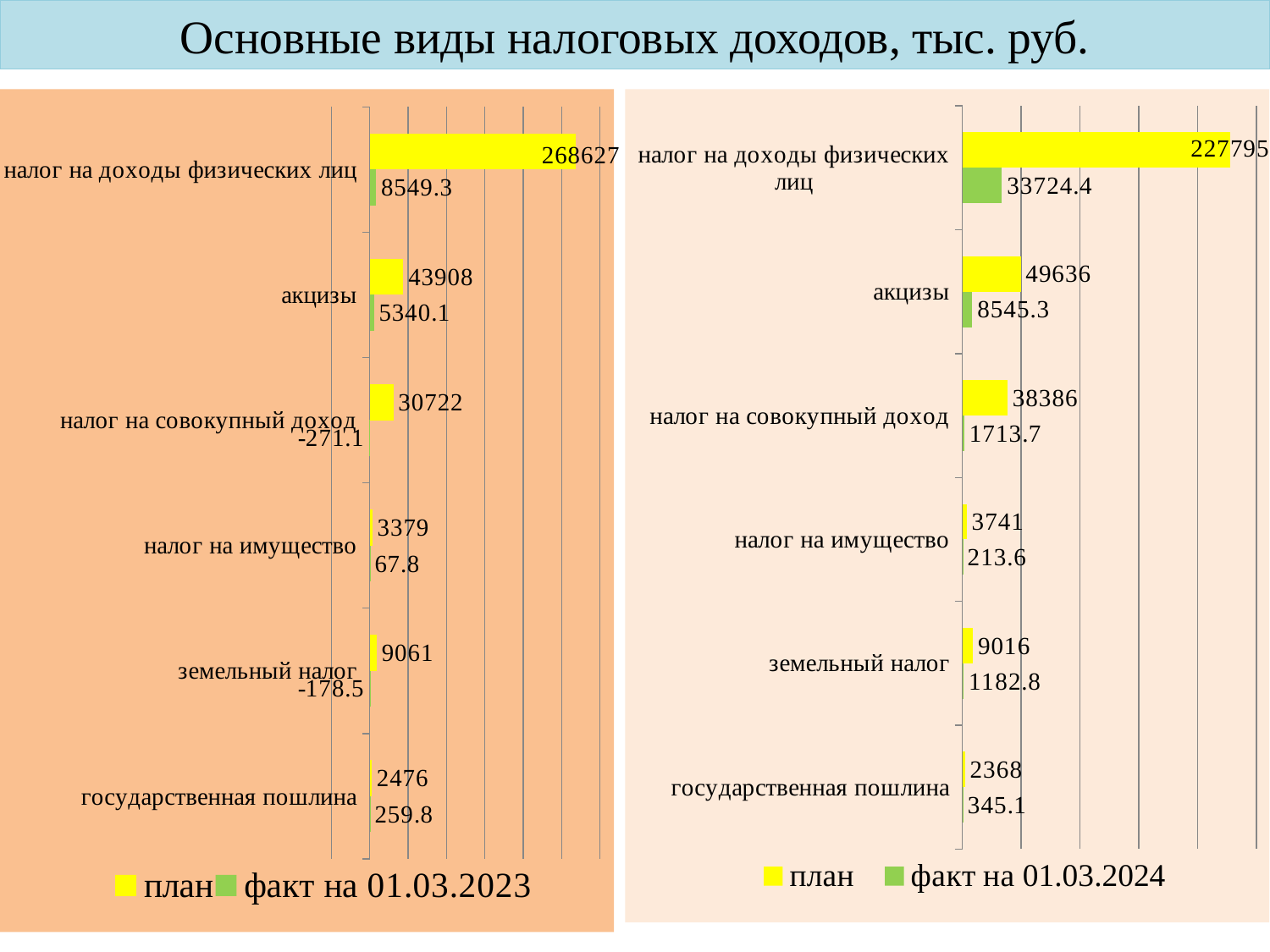
Which is larger: the план value for акцизы in the left chart or in the right chart? right chart (49636) In the left chart (факт на 01.03.2023), which category has the lowest факт value? налог на совокупный доход In the left chart (факт на 01.03.2023), what is the факт value for земельный налог? -178.5 In the right chart (факт на 01.03.2024), what is the план value for государственная пошлина? 2368 In the left chart (факт на 01.03.2023), what is the план value for налог на доходы физических лиц? 268627 How many series does the legend of the right chart list? 2 What type of chart is the left chart? bar chart In the right chart (факт на 01.03.2024), what is the факт value for акцизы? 8545.3 How many categories are shown in the left chart (факт на 01.03.2023)? 6 In the right chart (факт на 01.03.2024), what is the difference between the план and факт values for налог на имущество? 3527.4 What is the title of the slide? Основные виды налоговых доходов, тыс. руб. In the right chart (факт на 01.03.2024), which category has the highest план value? налог на доходы физических лиц